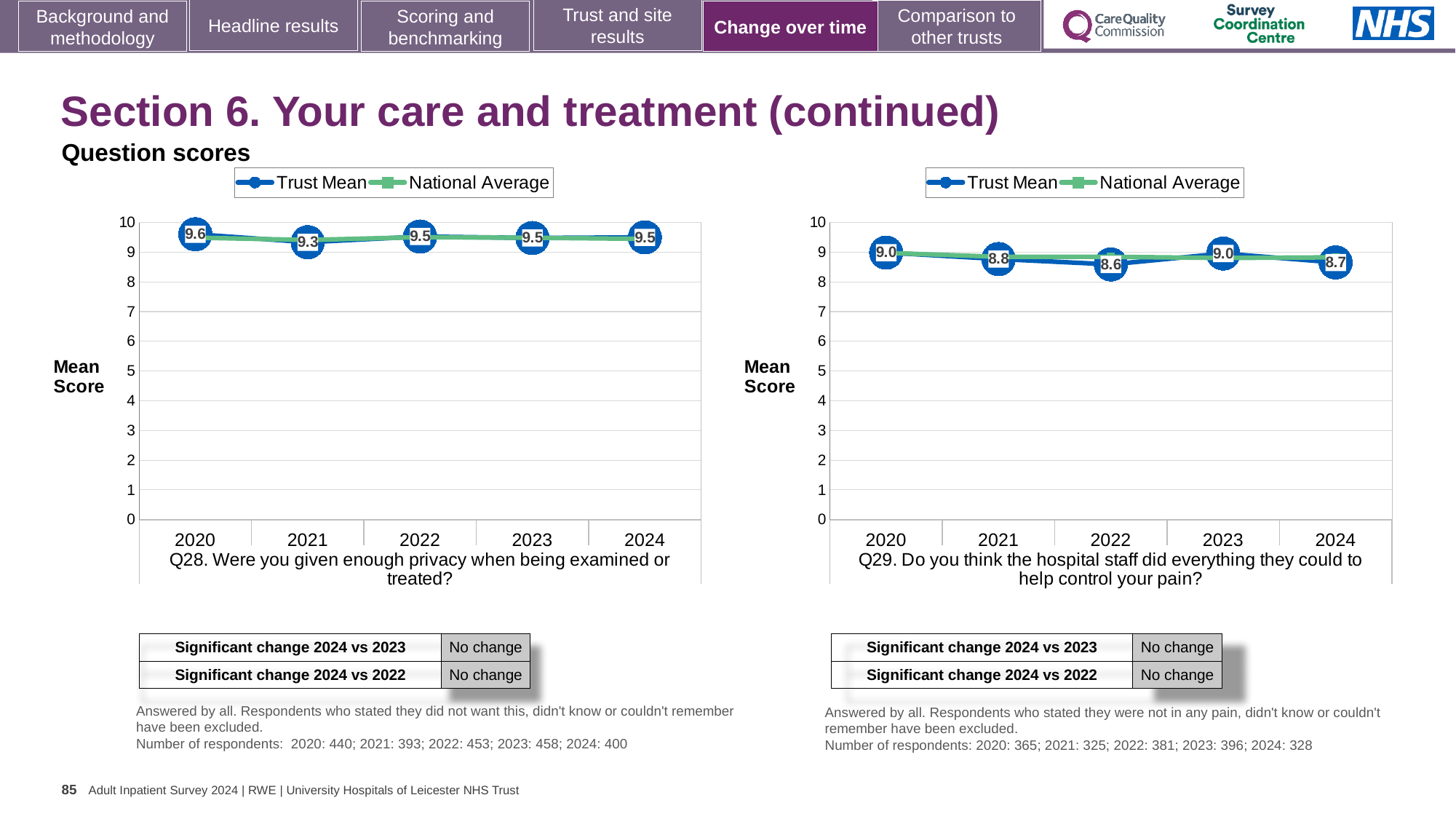
On the Q29 chart (right), is the Trust Mean value for 2021 greater or less than 5? greater On the Q28 chart (left), what is the difference between the Trust Mean scores for 2020 and 2021? 0.3 On the Q29 chart (right), what is the Trust Mean score for 2022? 8.6 On the Q29 chart (right), is the Trust Mean score for 2023 higher or lower than for 2022? higher On the Q29 chart (right), what is the Trust Mean score for 2024? 8.7 How many series does the legend of the Q29 chart (right) list? 2 How many years are shown on the x axis of the Q28 chart (left)? 5 On the Q28 chart (left), which year has the highest Trust Mean score? 2020 On the Q28 chart (left), what is the Trust Mean score for 2020? 9.6 What type of chart is used for the Q28 chart (left)? Line chart On the Q28 chart (left), what is the Trust Mean score for 2021? 9.3 On the Q29 chart (right), which year has the lowest Trust Mean score? 2022